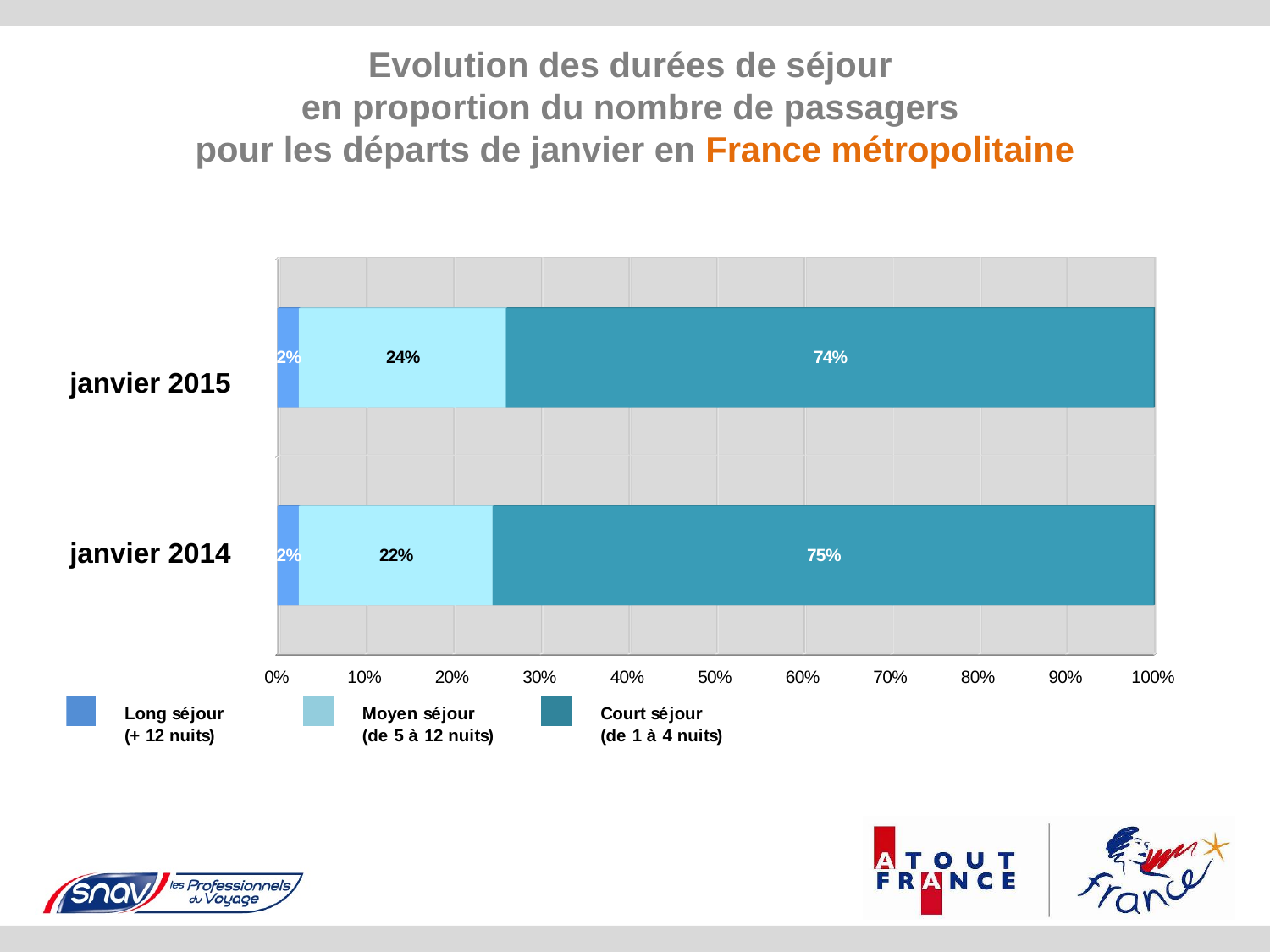
What is the difference between the Moyen séjour values for janvier 2015 and janvier 2014? 2% Which segment is the largest in the janvier 2015 bar? Court séjour (de 1 à 4 nuits) What is the total of the janvier 2015 stacked bar? 100% Which year has the larger Court séjour value, janvier 2015 or janvier 2014? janvier 2014 What is the value for Long séjour (+ 12 nuits) in janvier 2015? 2% How many categories (years) are shown on the chart? 2 How many series does the legend list? 3 What is the value for Court séjour (de 1 à 4 nuits) in janvier 2015? 74% What is the value for Moyen séjour (de 5 à 12 nuits) in janvier 2014? 22% What is the value for Court séjour (de 1 à 4 nuits) in janvier 2014? 75% Which segment is the smallest in the janvier 2014 bar? Long séjour (+ 12 nuits) What kind of chart is shown on the slide? Stacked bar chart